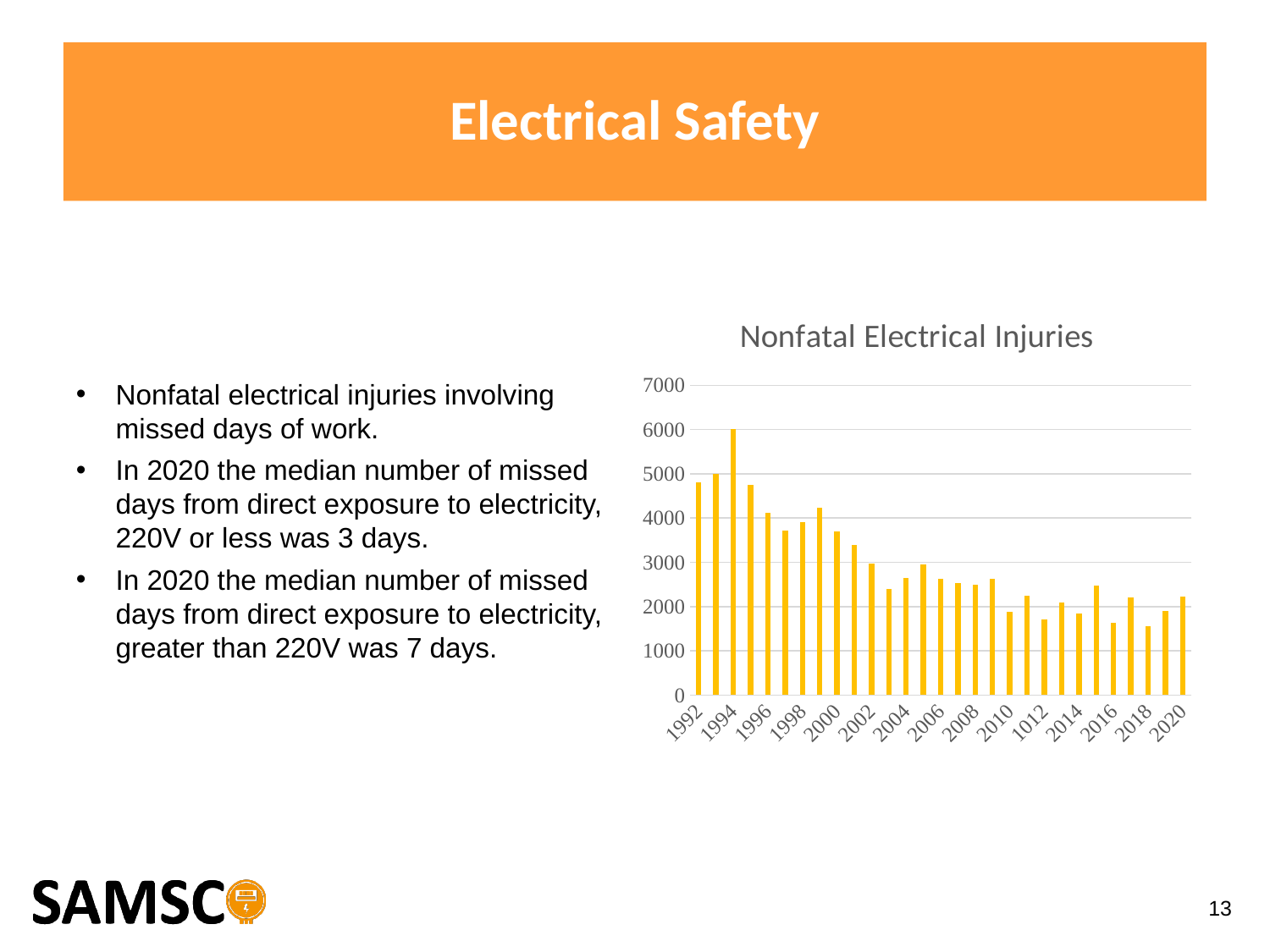
What is the title of the chart? Nonfatal Electrical Injuries Do the values generally rise or fall from 1992 to 2020? Fall Is the value for 2014 greater or less than 3000? less Is the value for 2020 greater or less than 3000? less What kind of chart is shown on the slide? Bar chart Which year has the larger value, 1992 or 2020? 1992 Is the value for 2000 greater or less than 3000? greater What is the highest value shown on the vertical axis? 7000 Which year has the highest number of nonfatal electrical injuries? 1994 Which year has the larger value, 1994 or 2010? 1994